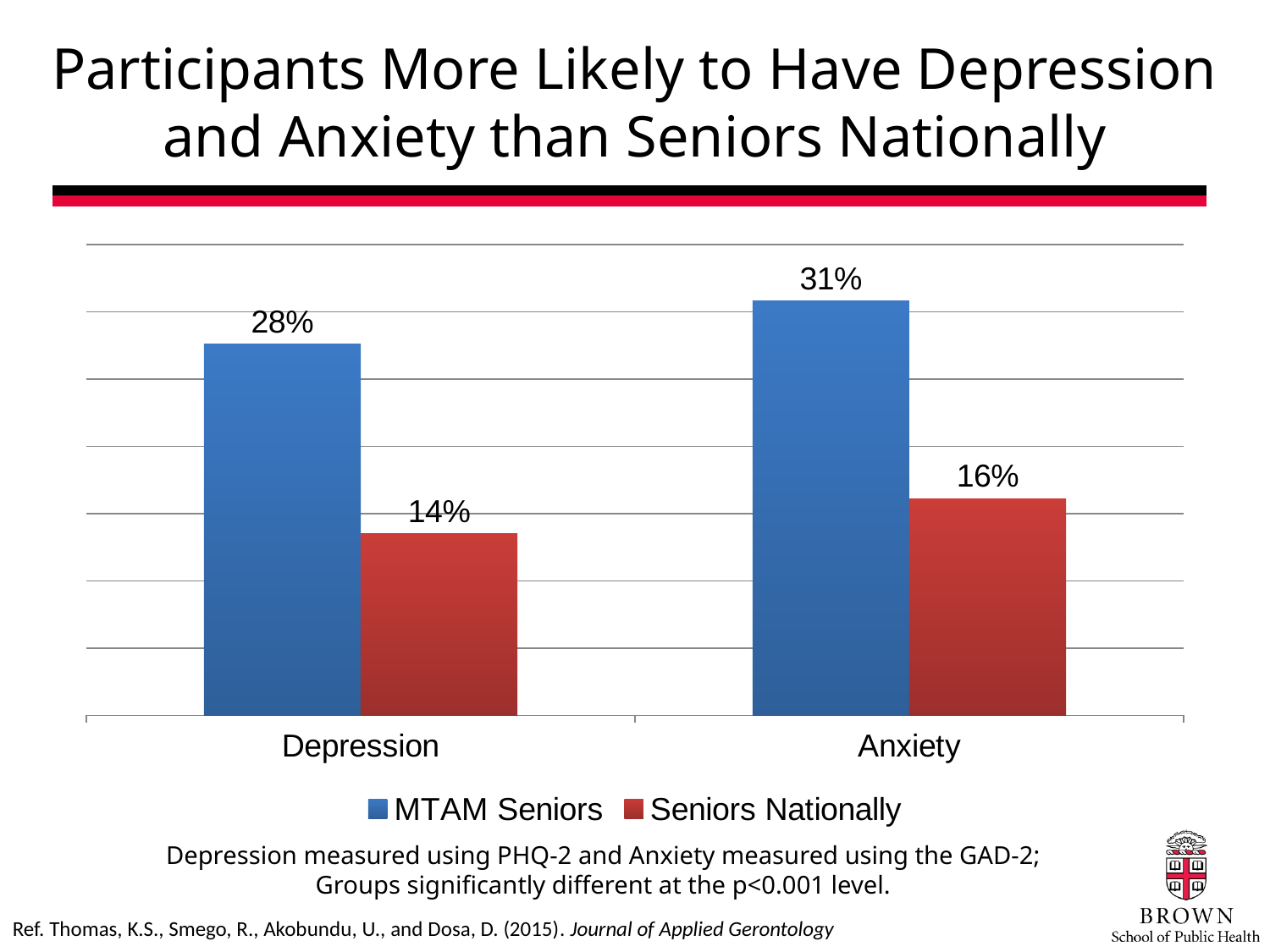
How many series does the legend list? 2 How many categories are shown on the x axis? 2 What is the value for MTAM Seniors in the Anxiety category? 31% What is the value for Seniors Nationally in the Depression category? 14% What is the difference between MTAM Seniors and Seniors Nationally in the Depression category? 14% What is the difference between MTAM Seniors and Seniors Nationally in the Anxiety category? 15% What is the value for Seniors Nationally in the Anxiety category? 16% What is the value for MTAM Seniors in the Depression category? 28% What kind of chart is shown on the slide? Bar chart Which category has the lowest value for Seniors Nationally? Depression Which category has the highest value for MTAM Seniors? Anxiety Which is larger: the Anxiety value for MTAM Seniors or the Depression value for MTAM Seniors? Anxiety value for MTAM Seniors